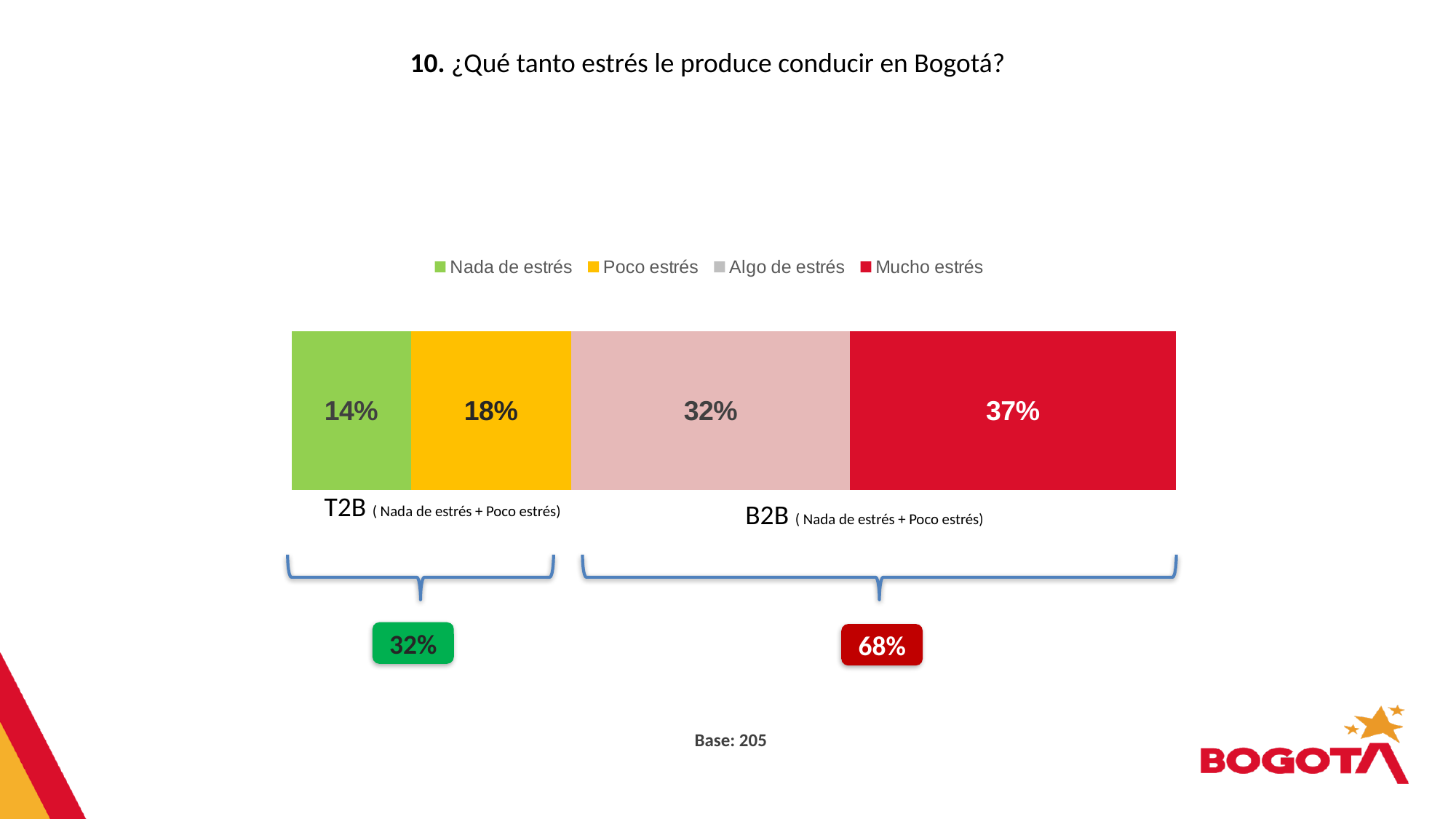
What percentage of respondents reported "Mucho estrés"? 37% What is the base (number of respondents) shown on the slide? 205 Which is larger, the share for "Algo de estrés" or the share for "Poco estrés"? Algo de estrés Which stress level has the highest percentage? Mucho estrés What percentage of respondents reported "Nada de estrés"? 14% What kind of chart is shown on the slide? Stacked bar chart Which stress level has the lowest percentage? Nada de estrés How many series does the legend list? 4 What percentage of respondents reported "Poco estrés"? 18% What is the difference in percentage points between "Mucho estrés" and "Nada de estrés"? 23 What is the T2B value (Nada de estrés + Poco estrés) shown below the bar? 32% What percentage of respondents reported "Algo de estrés"? 32%